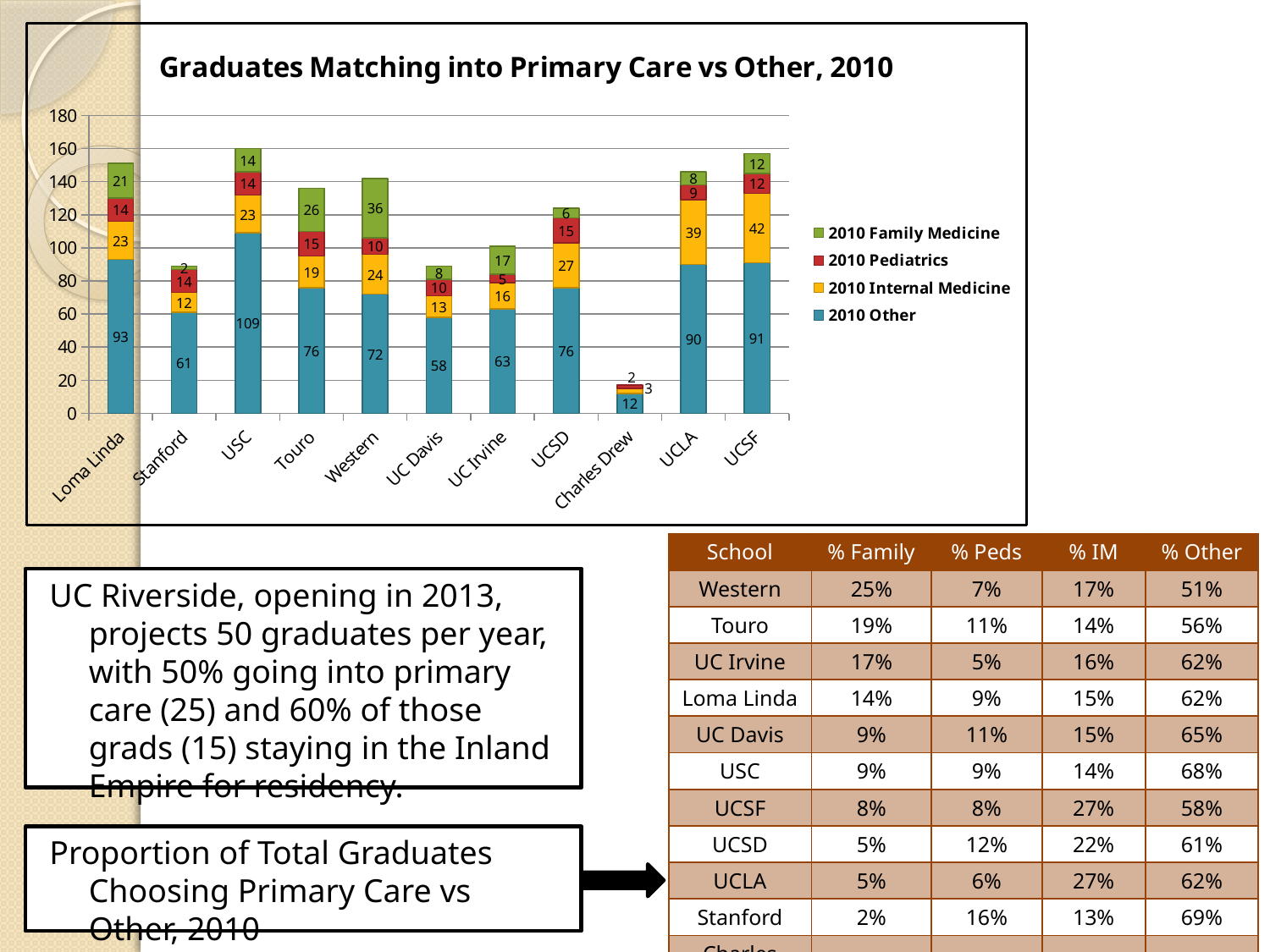
Which is larger, the 2010 Family Medicine value for Touro or for Loma Linda? Touro What is the 2010 Other value for USC? 109 What type of chart is shown on the slide? stacked bar chart What is the total of the stacked bar for UCLA? 146 How many schools are shown on the x axis of the chart? 11 How many series does the chart legend list? 4 Which school has the lowest 2010 Other value? Charles Drew What is the 2010 Internal Medicine value for UCSF? 42 Is the total stacked bar for Stanford greater or less than 100? less What is the 2010 Family Medicine value for Western? 36 What is the difference between the 2010 Internal Medicine values for UCLA and UCSD? 12 Which school has the highest 2010 Other value? USC